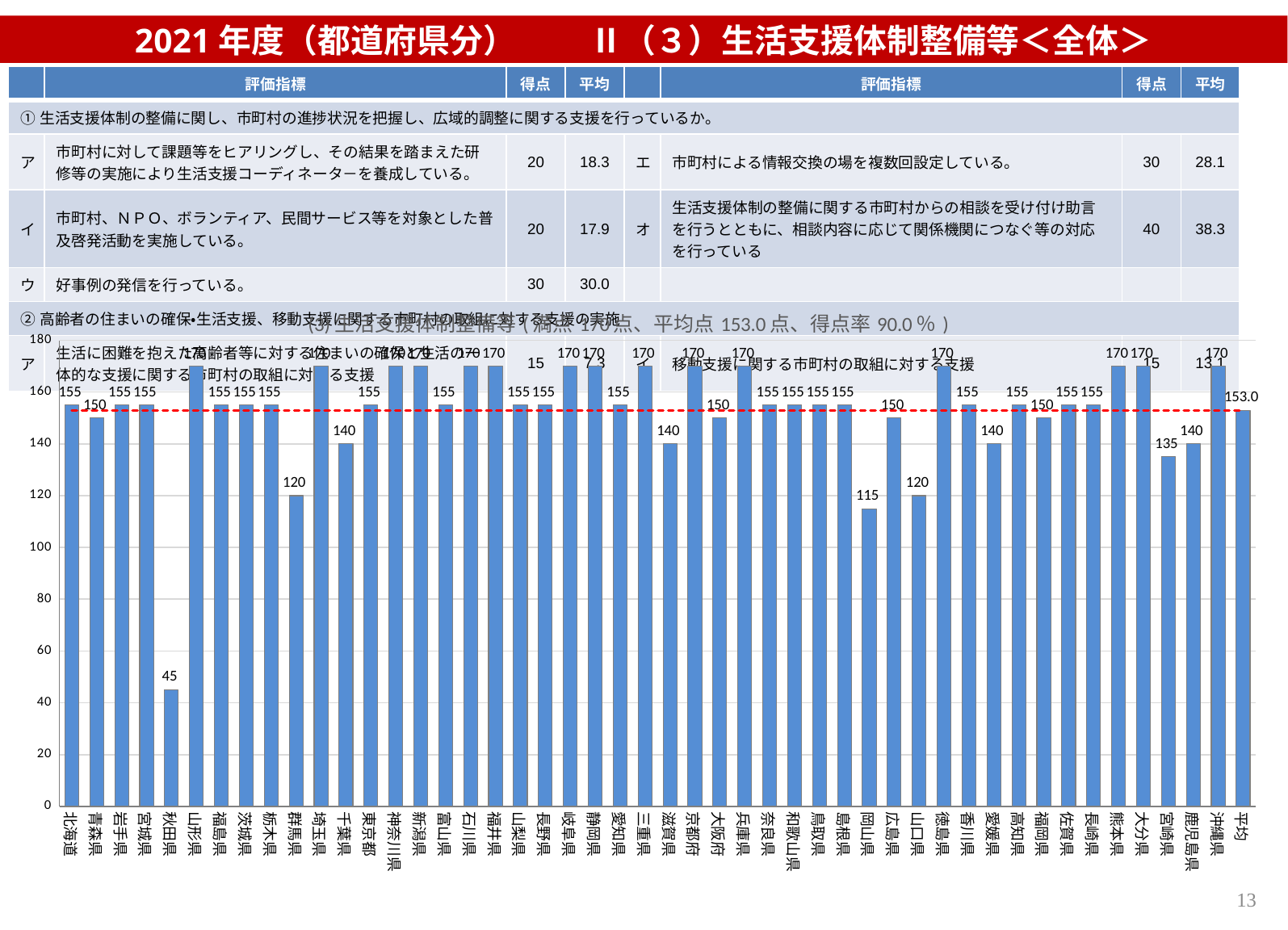
What is the value for 山口県 in the bar chart? 120 How many bars are plotted in the chart, including the 平均 bar? 48 Which has the larger value, 群馬県 or 千葉県? 千葉県 Which prefecture has the lowest value in the bar chart? 秋田県 What is the difference between the values for 山形県 and 秋田県? 125 What is the value shown for the 平均 bar at the right end of the chart? 153.0 What value does the horizontal red dashed line in the chart mark? 153.0 What is the value for 秋田県 in the bar chart? 45 What is the value for 宮崎県 in the bar chart? 135 What is the value for 岡山県 in the bar chart? 115 Is the value for 秋田県 greater or less than 60? less What kind of chart is shown on the slide? bar chart with a horizontal dashed average line